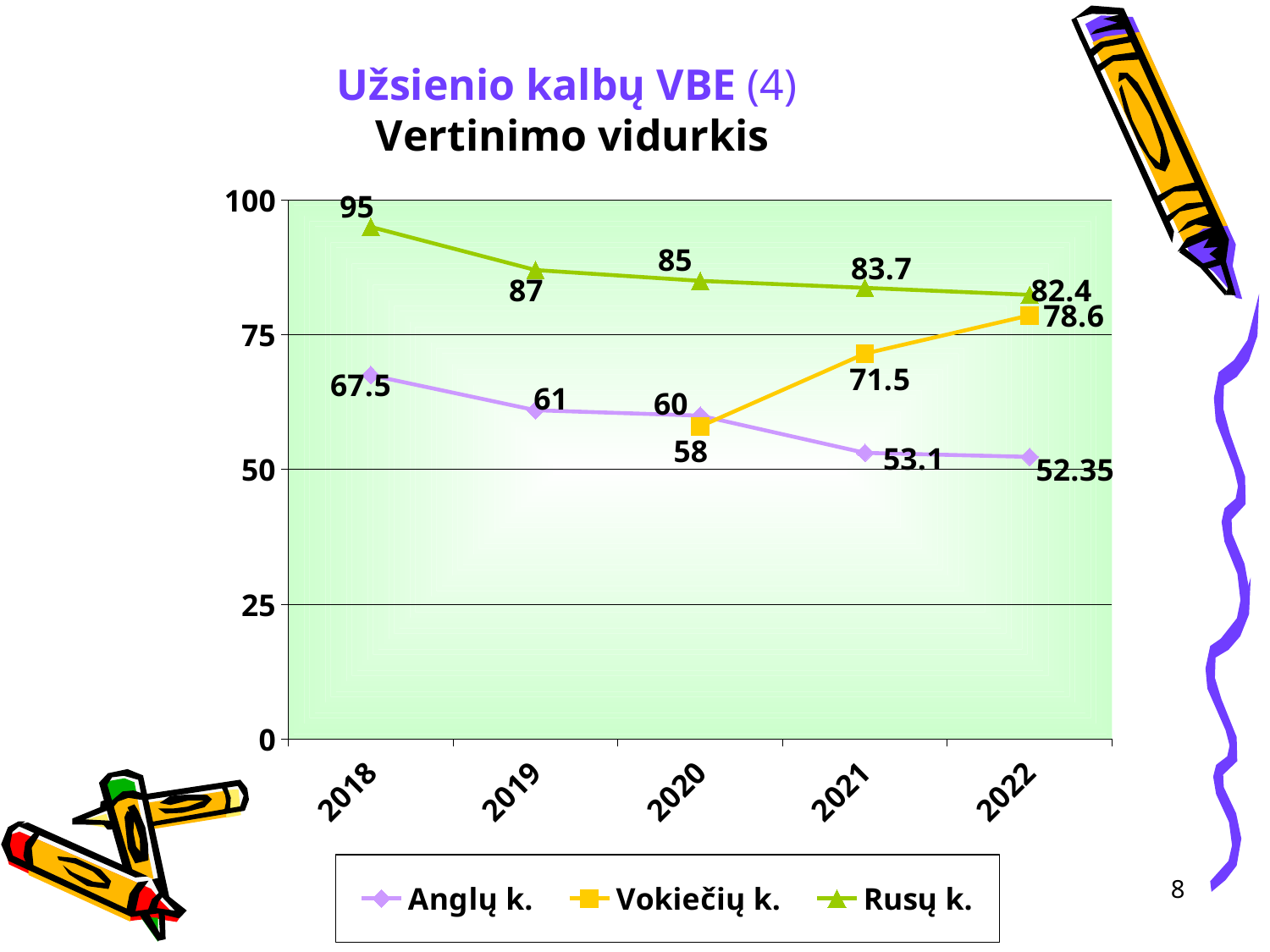
How many years are shown on the x axis? 5 What is the difference between the Rusų k. value in 2018 and in 2022? 12.6 What is the value for Rusų k. in 2018? 95 What is the value for Anglų k. in 2022? 52.35 Which is larger in 2020, the Anglų k. value or the Vokiečių k. value? Anglų k. How many series does the legend list? 3 Which series is drawn with triangle markers? Rusų k. What is the value for Vokiečių k. in 2021? 71.5 In which year is the Anglų k. value highest? 2018 What kind of chart is shown on the slide? line chart Does the Anglų k. series rise or fall from 2018 to 2022? fall In which year is the Vokiečių k. value lowest? 2020